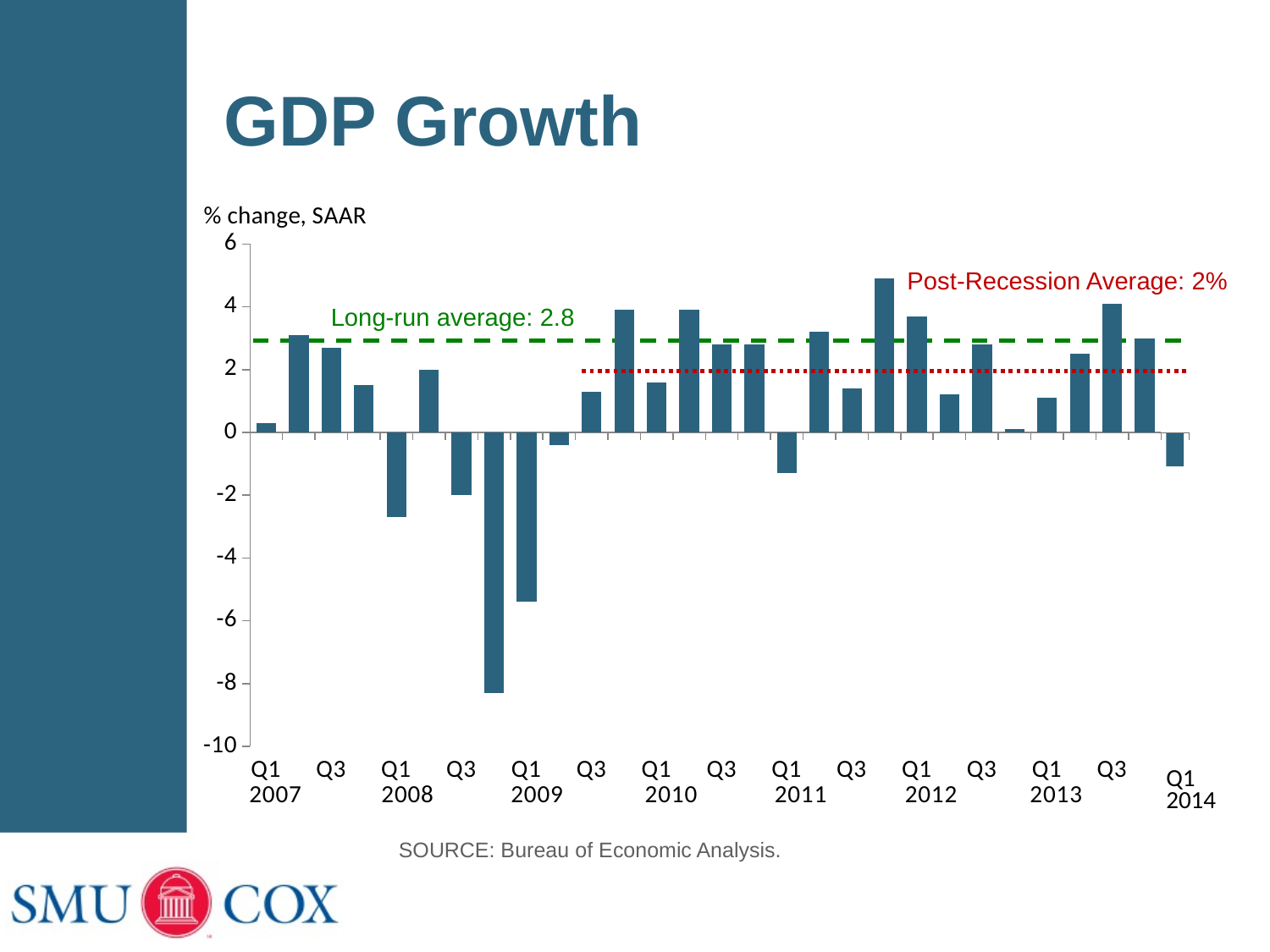
Which is larger, the value for Q1 2007 or the value for Q2 2007? Q2 2007 Is the value for Q1 2009 greater or less than -4? less Is the value for Q4 2008 greater or less than -6? less What kind of chart is shown on the GDP Growth slide? bar chart Which quarter has the highest GDP growth value in the chart? Q4 2011 What post-recession average is labelled on the chart? 2% Do the values rise or fall from Q4 2008 to Q4 2009? rise Which quarter has the lowest GDP growth value in the chart? Q4 2008 Is the value for Q4 2011 greater or less than 4? greater Which is larger, the value for Q4 2011 or the value for Q1 2012? Q4 2011 What long-run average value is labelled on the chart? 2.8